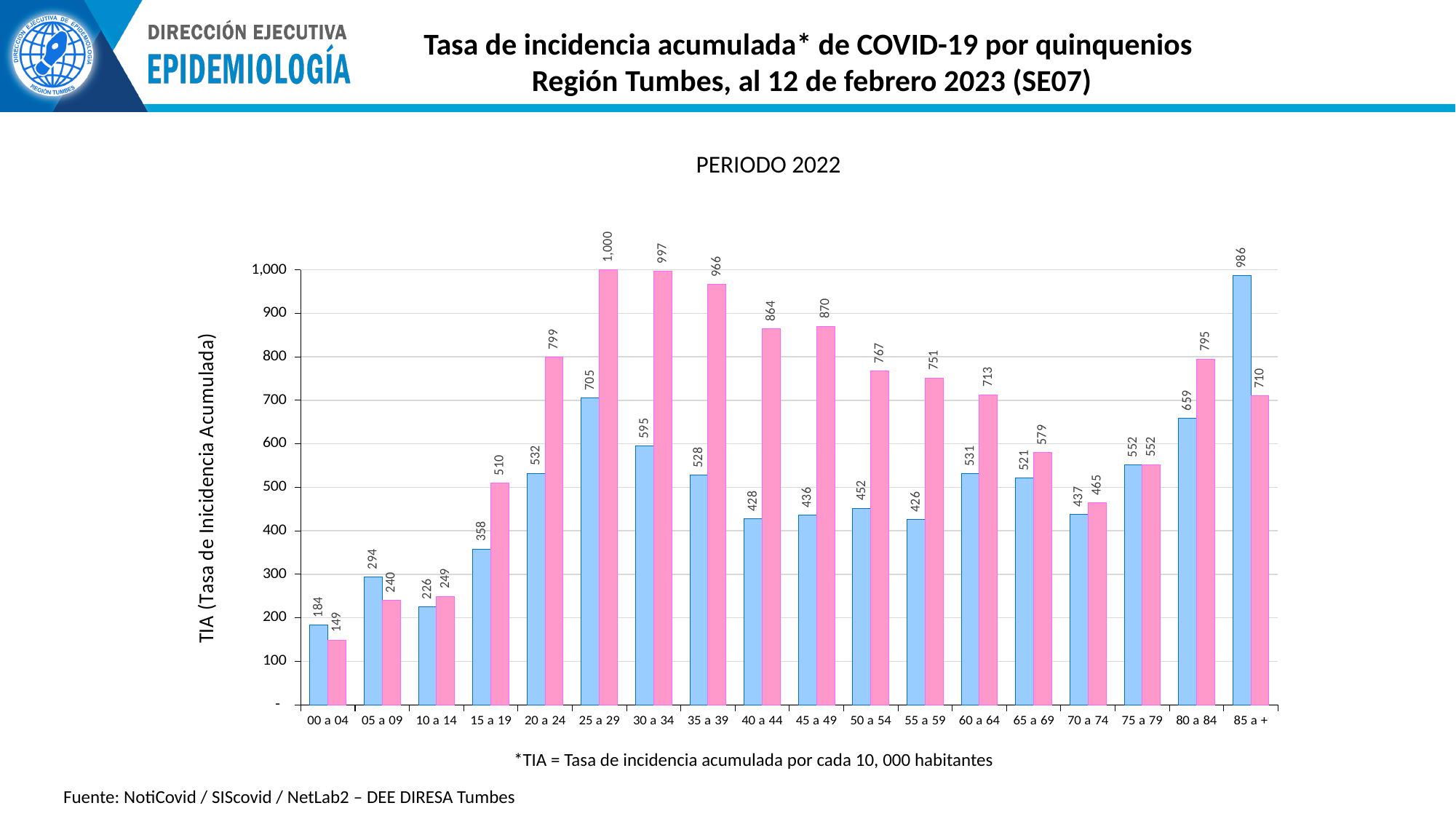
What is the value of the blue bar for the 25 a 29 age group? 705 For the 85 a + age group, which bar is larger, the blue one or the pink one? the blue one What is the difference between the pink bar and the blue bar for the 20 a 24 age group? 267 What is the label of the y axis? TIA (Tasa de Incidencia Acumulada) How many age groups are shown on the x axis? 18 What kind of chart is shown on the slide? bar chart What is the value of the pink bar for the 40 a 44 age group? 864 What is the value of the blue bar for the 00 a 04 age group? 184 Which age group has the highest pink bar? 25 a 29 Which age group has the highest blue bar? 85 a + What is the title shown above the chart? PERIODO 2022 Which age group has the lowest pink bar? 00 a 04